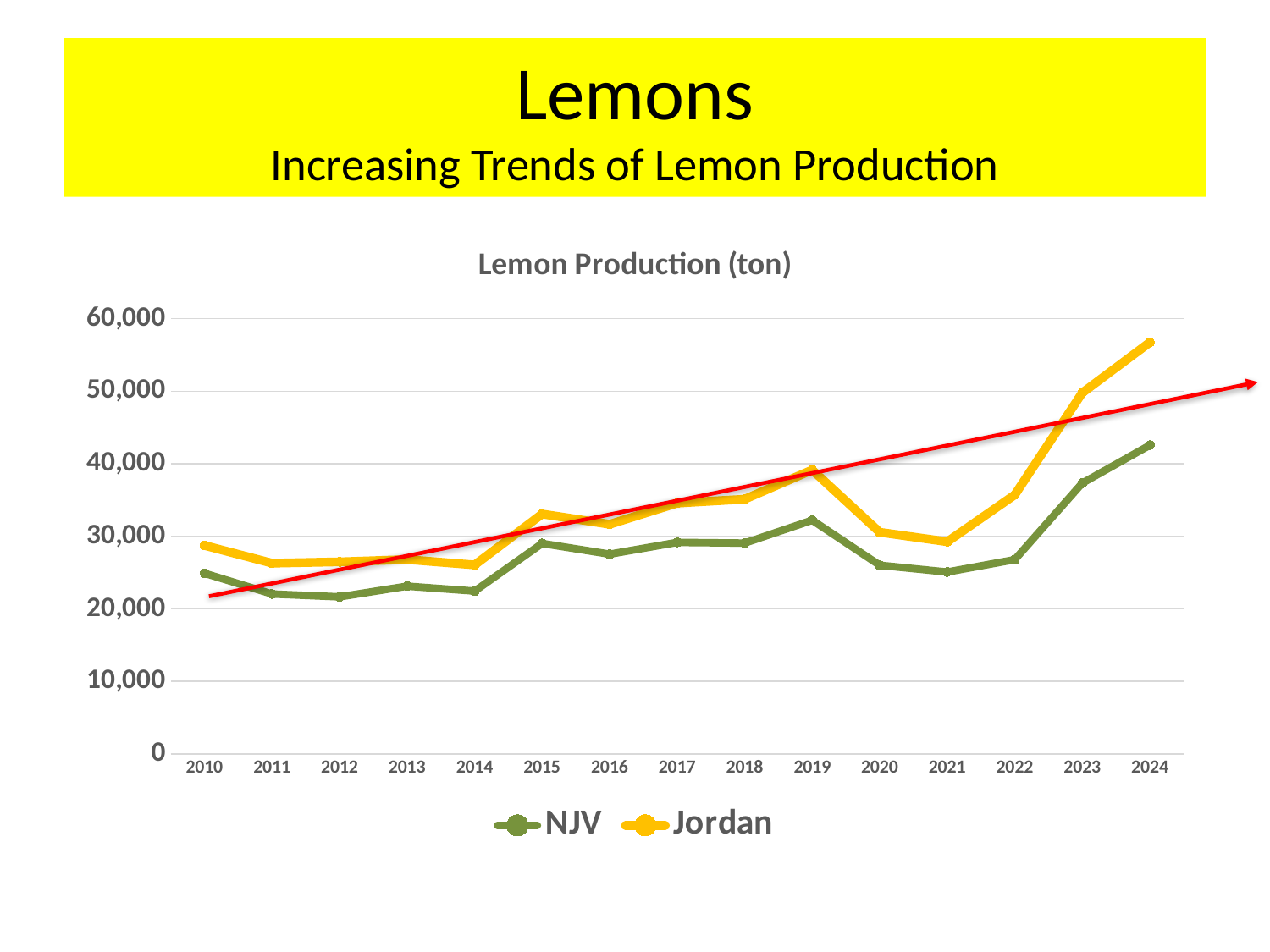
Which year has the highest value for Jordan? 2024 Which year has the highest value for NJV? 2024 Is the value for Jordan in 2024 greater or less than 50,000? greater Overall, do the values for Jordan rise or fall from 2010 to 2024? rise What kind of chart is shown on the slide? line chart In 2020, which series has the larger value, NJV or Jordan? Jordan Is the value for NJV in 2021 greater or less than 30,000? less Is the value for Jordan in 2015 greater or less than 30,000? greater How many series does the legend list? 2 What is the title of the chart? Lemon Production (ton) How many years are plotted along the x axis? 15